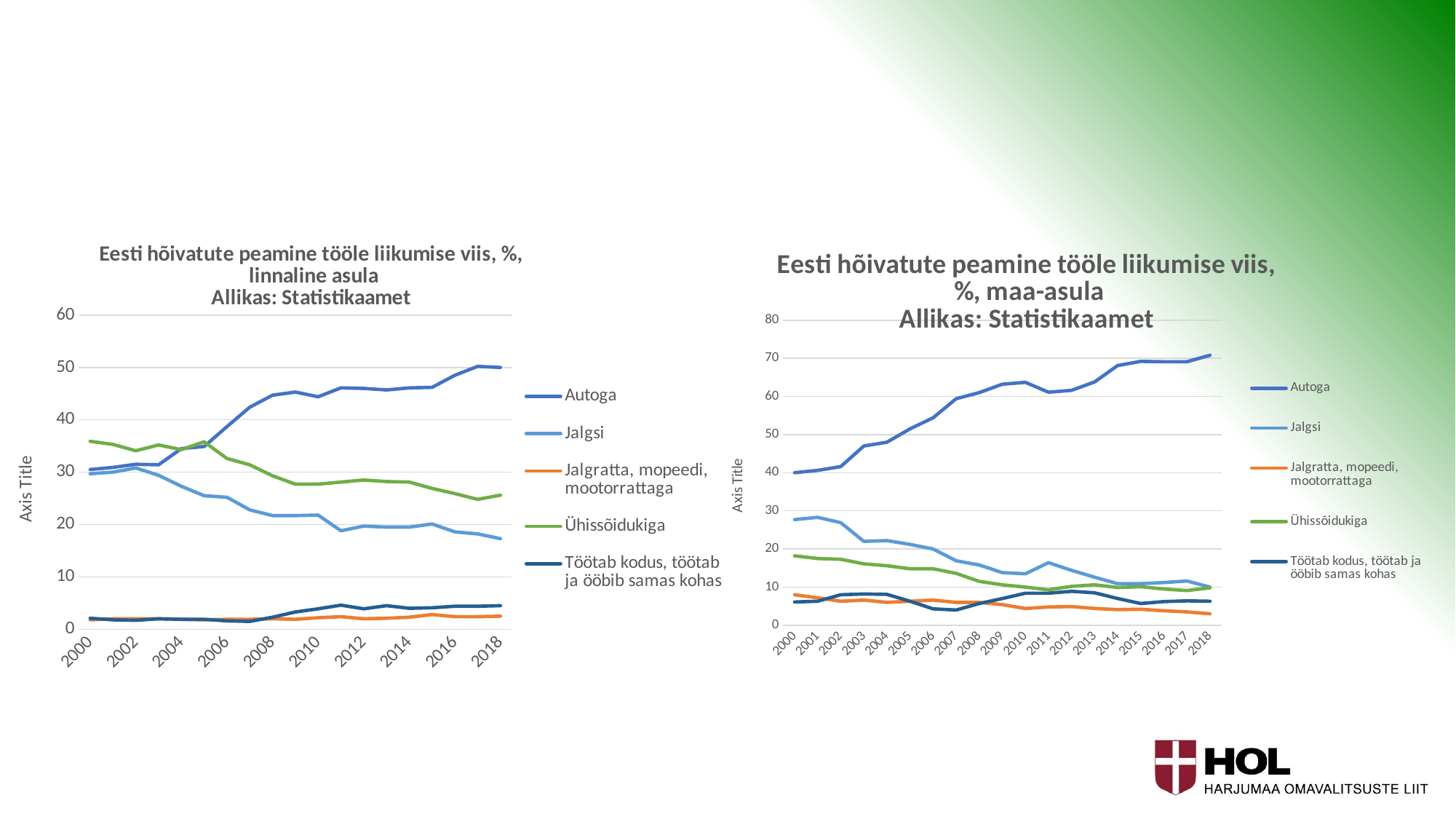
In the right chart (maa-asula), is the value for Ühissõidukiga in 2000 greater or less than 20? less In the left chart (linnaline asula), does the Autoga line rise or fall from 2000 to 2018? rise In the right chart (maa-asula), is the value for Autoga in 2018 greater or less than 60? greater In the right chart (maa-asula), which is larger in 2000: Jalgsi or Ühissõidukiga? Jalgsi In the left chart (linnaline asula), is the value for Jalgsi in 2018 greater or less than 20? less How many series does the legend of the right chart (maa-asula) list? 5 How many years are plotted along the x axis of the left chart (linnaline asula)? 19 In the left chart (linnaline asula), does the Jalgsi line rise or fall from 2000 to 2018? fall What kind of chart is the left chart, titled "Eesti hõivatute peamine tööle liikumise viis, %, linnaline asula"? line chart In the left chart (linnaline asula), which series has the highest value in 2018? Autoga What is the source named in the title of the right chart (maa-asula)? Statistikaamet